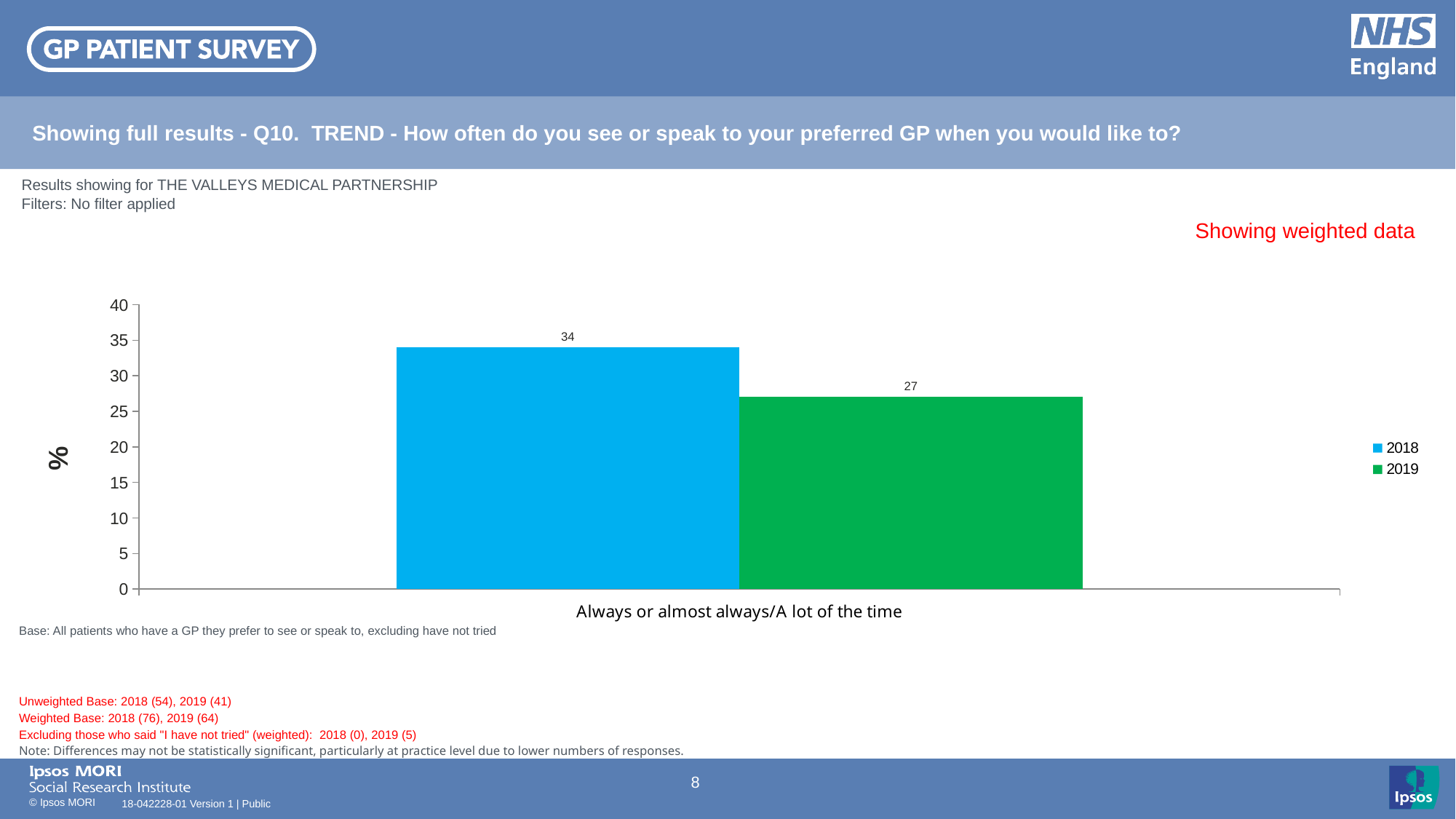
How many series does the legend list? 2 What is the label on the vertical axis of the chart? % Did the value fall or rise from 2018 to 2019? fall Is the 2018 value larger or smaller than the 2019 value? larger What is the difference between the 2018 and 2019 values? 7 Which year has the lower value for 'Always or almost always/A lot of the time'? 2019 Is the value for 2018 greater or less than 30? greater Is the value for 2019 greater or less than 30? less What kind of chart is shown on the slide? bar chart Which year has the higher value for 'Always or almost always/A lot of the time'? 2018 What is the value for 2019 for 'Always or almost always/A lot of the time'? 27 What is the value for 2018 for 'Always or almost always/A lot of the time'? 34